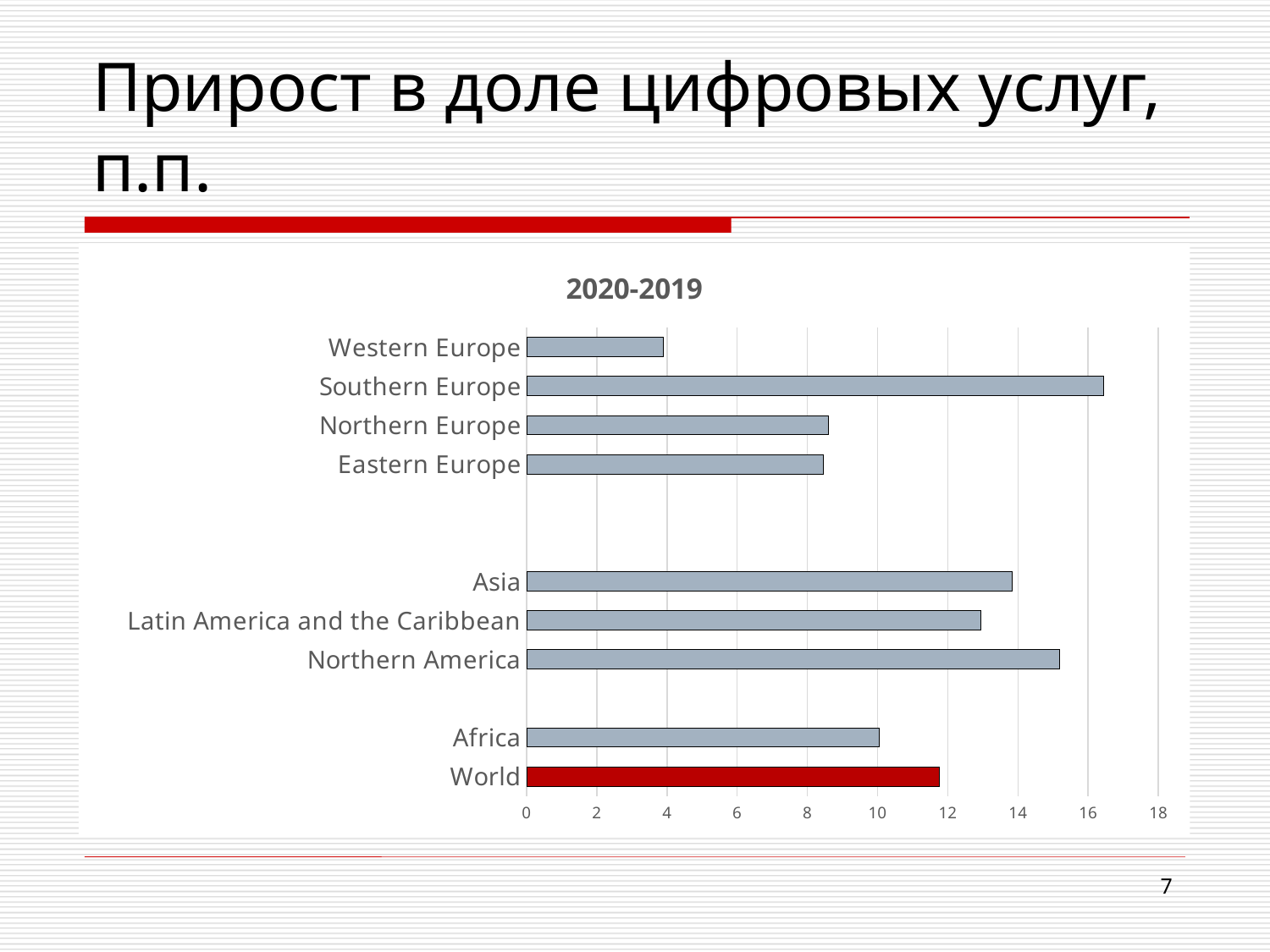
What is the title of the chart? 2020-2019 Is the value for Northern America greater or less than 14? greater Is the value for Western Europe greater or less than 6? less Is the value for Eastern Europe greater or less than 10? less What kind of chart is shown on the slide? bar chart Which category has the lowest value in the chart? Western Europe Which category has the highest value in the chart? Southern Europe Which category's bar is coloured red? World How many labeled categories are shown in the chart? 9 Which has the larger value, Asia or Northern America? Northern America Which has the larger value, Africa or World? World